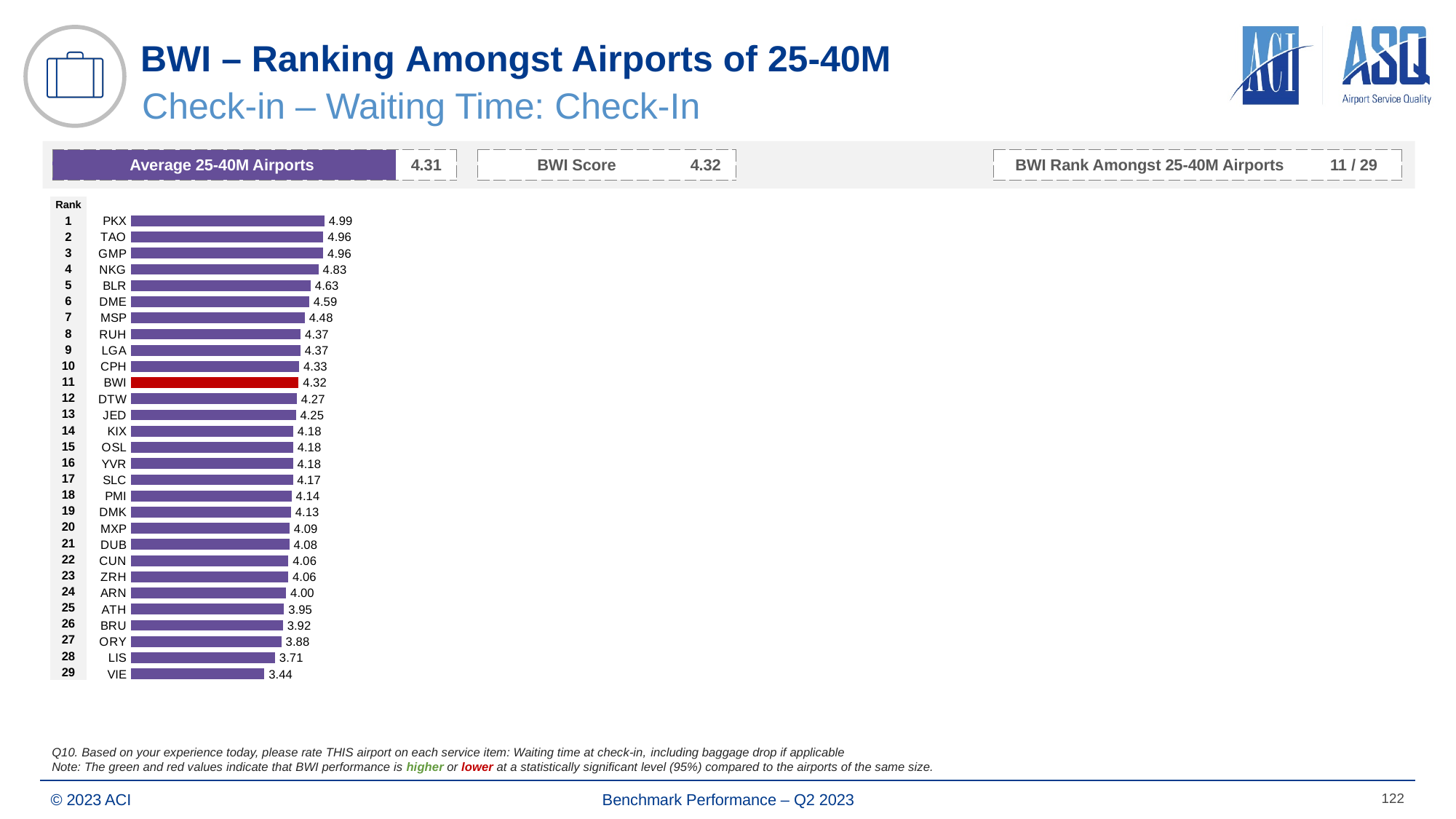
Which bar is coloured red? BWI What is the value for VIE? 3.44 Which airport has the highest value? PKX How many airports are ranked in the chart? 29 What is the difference between the values for PKX and VIE? 1.55 What kind of chart is shown? Bar chart Which airport has the lowest value? VIE What is the value for PKX? 4.99 Which has a larger value, MSP or LIS? MSP What is the difference between the values for BWI and DTW? 0.05 What is the value for BWI? 4.32 What is BWI's rank amongst 25-40M airports? 11 / 29